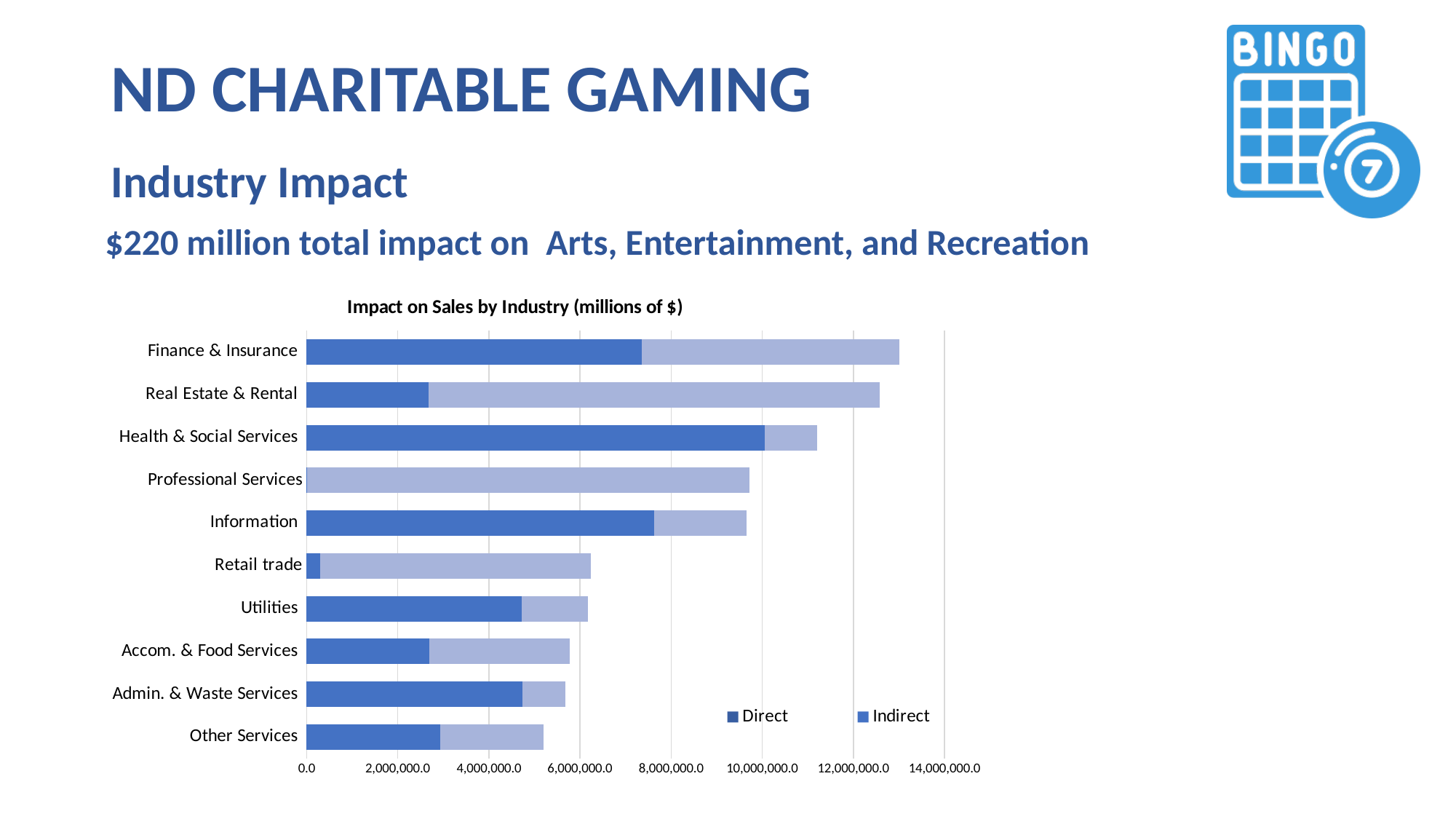
Is the total value for Finance & Insurance greater or less than 12,000,000.0? greater Is the total value for Other Services greater or less than 6,000,000.0? less How many industry categories are plotted in the chart? 10 What type of chart is shown on the slide? Stacked bar chart Which industry has the larger Direct value, Health & Social Services or Real Estate & Rental? Health & Social Services Is the total value for Professional Services greater or less than 10,000,000.0? less What are the two series named in the legend? Direct and Indirect How many series does the legend list? 2 Which industry has the largest total impact on sales? Finance & Insurance Do the total bar lengths increase or decrease going from the top category to the bottom category? decrease Which industry has the smallest total impact on sales? Other Services What is the title of the chart? Impact on Sales by Industry (millions of $)